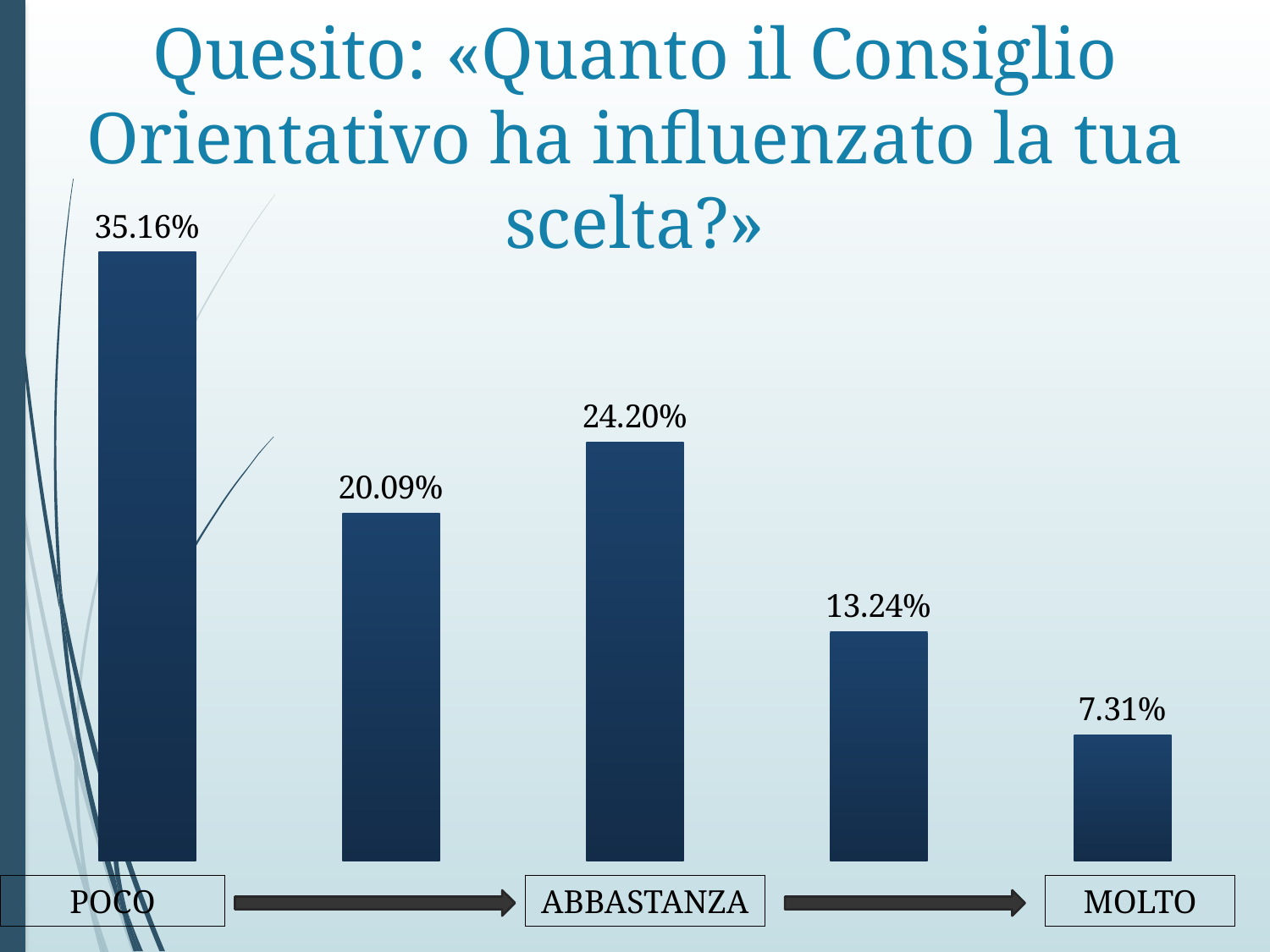
Which labelled category has the highest value? POCO What value is shown for the ABBASTANZA bar? 24.20% What is the difference between the ABBASTANZA value and the MOLTO value? 16.89% Which labelled category has the lowest value? MOLTO What value is shown on the fourth bar from the left? 13.24% What value is shown for the POCO bar? 35.16% Which is larger, the value for POCO or the value for ABBASTANZA? POCO How many bars are plotted in the chart? 5 What value is shown for the MOLTO bar? 7.31% What is the difference between the POCO value and the MOLTO value? 27.85% What value is shown on the second bar from the left? 20.09% What kind of chart is shown on the slide? Bar chart